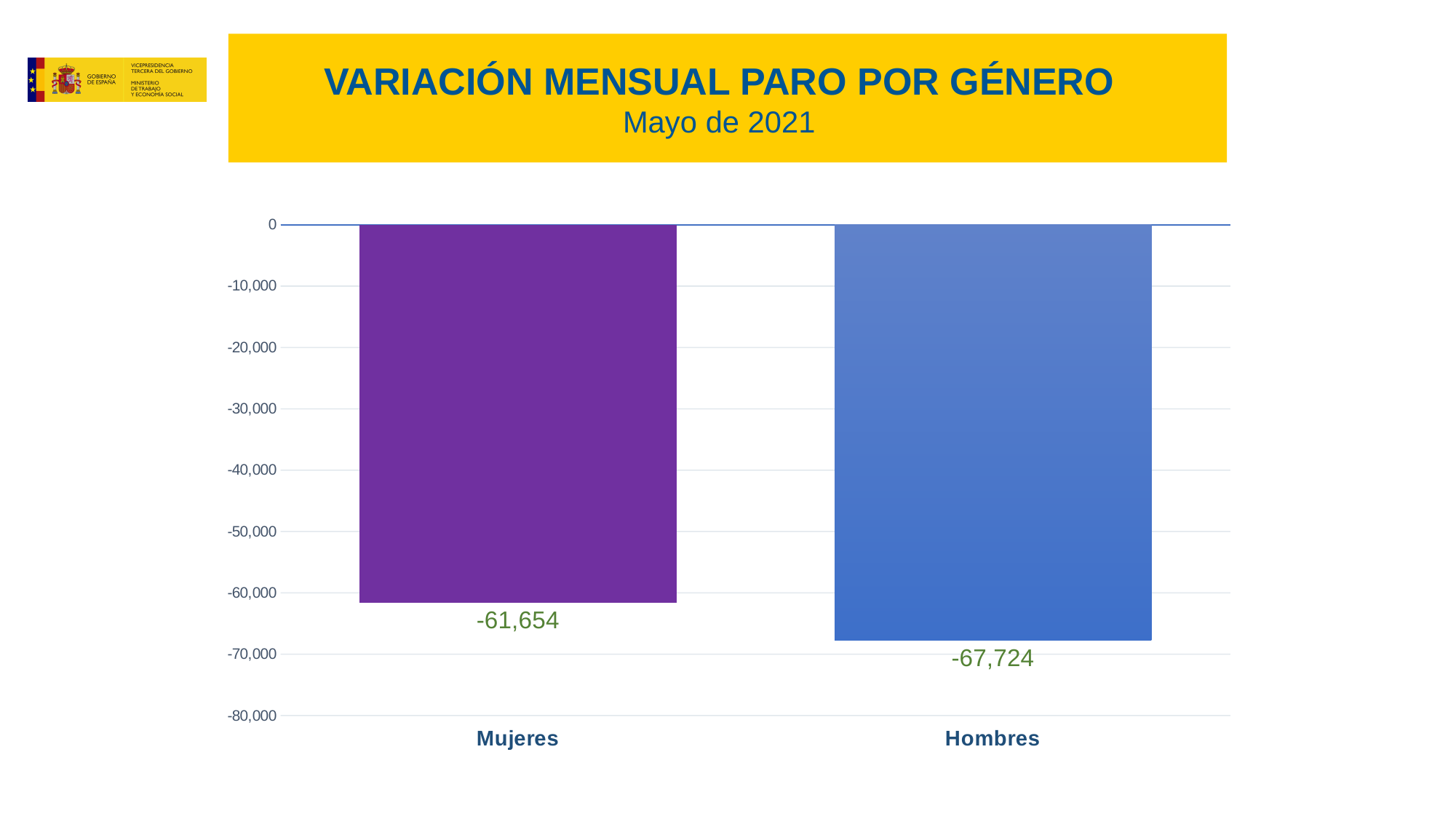
Which category has the lowest (most negative) value? Hombres Is the value for Mujeres greater or less than -70,000? greater Which category has the highest (least negative) value? Mujeres Which bar extends further below zero, Mujeres or Hombres? Hombres What kind of chart is shown on the slide? bar chart Is the value for Hombres greater or less than -60,000? less What is the value for Mujeres? -61,654 What is the value for Hombres? -67,724 What colour is the bar for Mujeres? purple What is the difference between the values for Mujeres and Hombres? 6,070 How many categories are shown in the chart? 2 What is the title of the chart? VARIACIÓN MENSUAL PARO POR GÉNERO